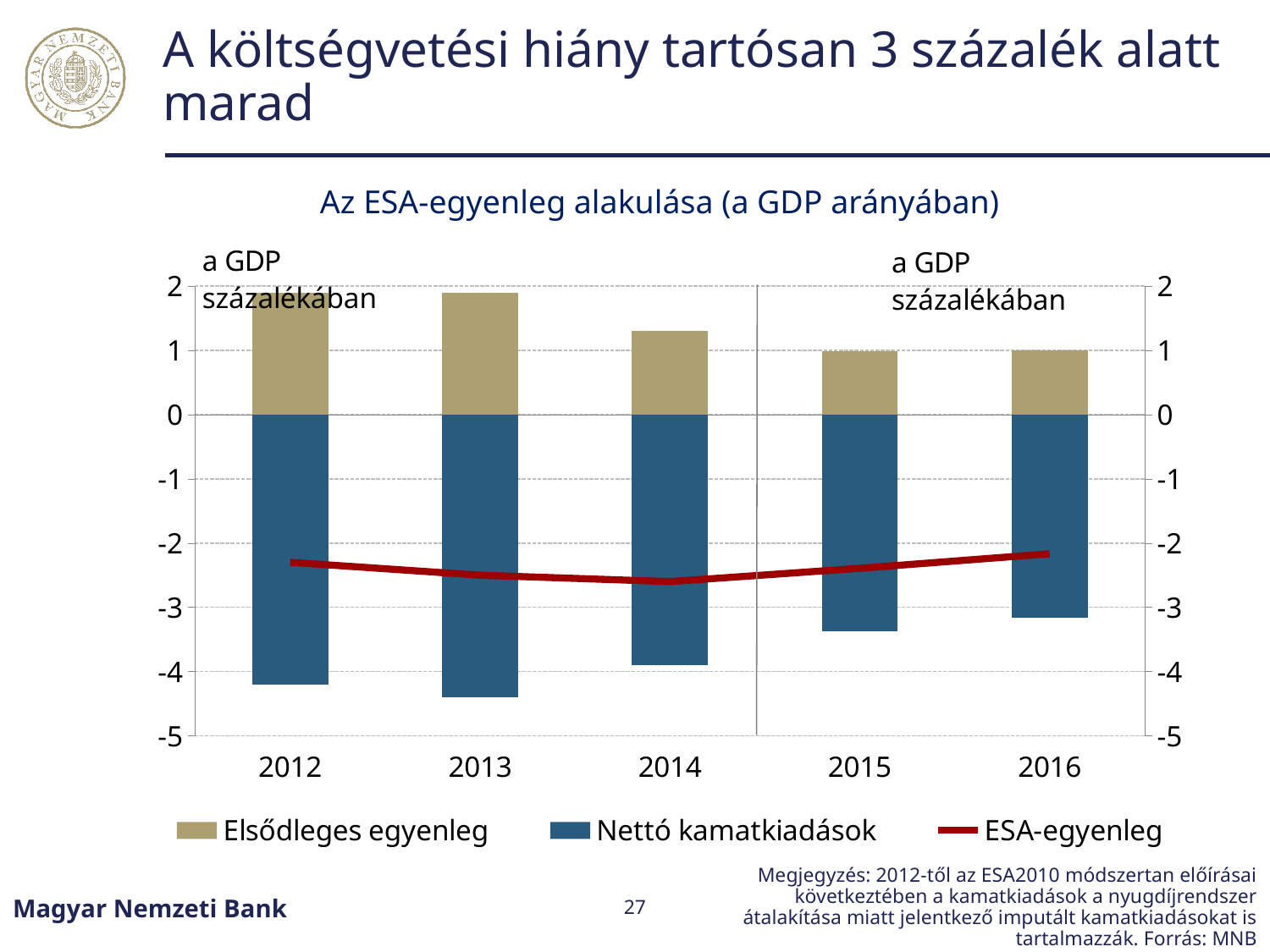
In which year is the Nettó kamatkiadások bar the lowest (most negative)? 2013 How many series does the legend list? 3 Is the value of Nettó kamatkiadások for 2015 greater or less than -4? greater In which year is the Nettó kamatkiadások bar the highest (least negative)? 2016 Which is larger, the Elsődleges egyenleg for 2014 or for 2015? 2014 What kind of chart is shown on the slide? A bar chart with a line series What is the title of the chart? Az ESA-egyenleg alakulása (a GDP arányában) Does the Elsődleges egyenleg rise or fall from 2012 to 2016? fall Is the value of Nettó kamatkiadások for 2012 greater or less than -4? less Which series is drawn as a red line? ESA-egyenleg How many years are shown on the x axis? 5 Is the ESA-egyenleg value for 2014 greater or less than -2? less